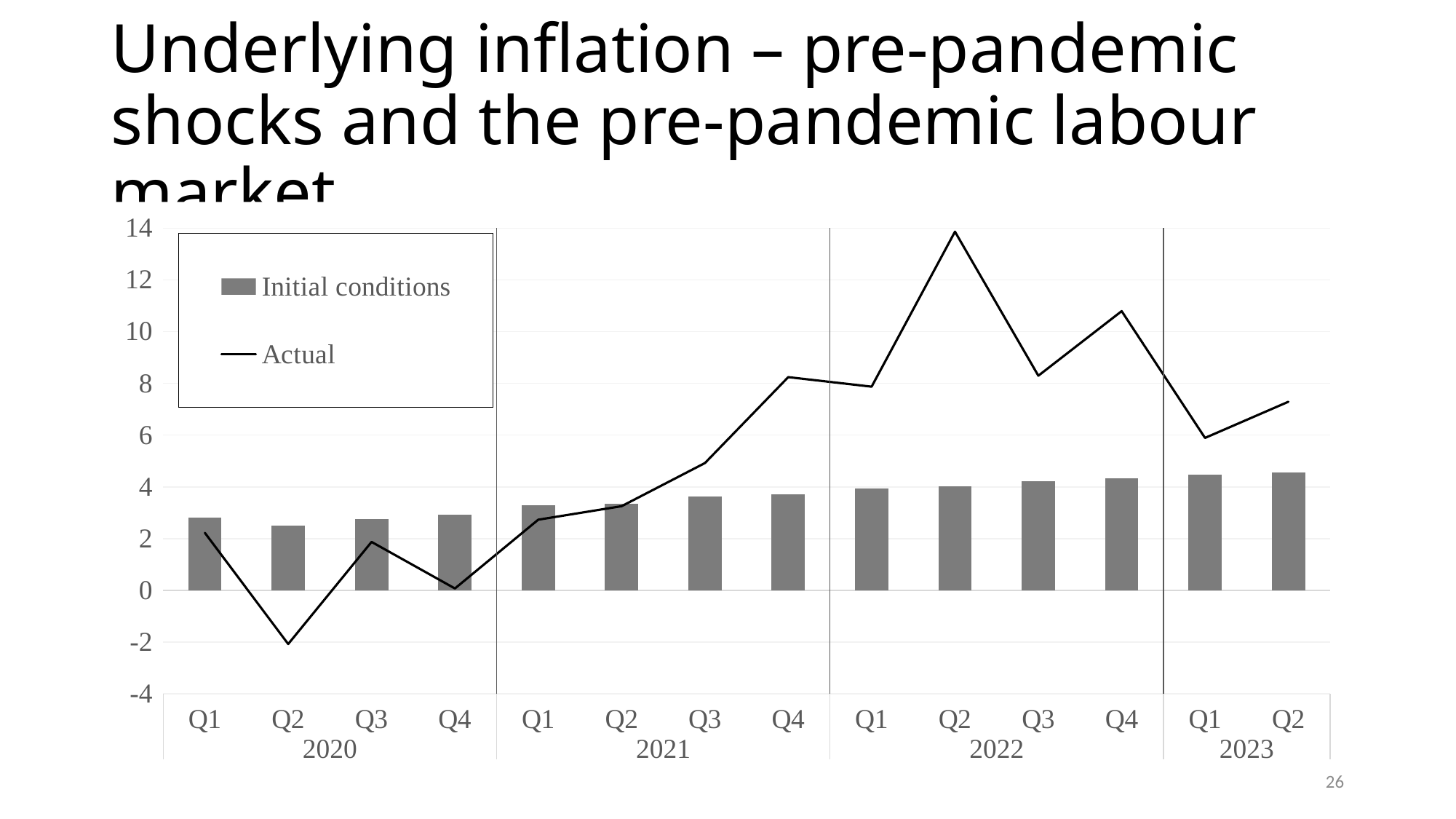
In which quarter does the Actual line reach its highest value? Q2 2022 Which series is drawn as a line? Actual Do the Initial conditions bars generally rise or fall from Q1 2021 to Q2 2023? rise How many series does the legend list? 2 What kind of chart is shown on the slide? A combined bar and line chart Which series is drawn as bars? Initial conditions Is the Actual value for Q2 2022 greater or less than 12? greater In Q2 2022, which is larger: the Actual value or the Initial conditions value? Actual How many quarters are plotted along the x axis? 14 In which quarter does the Actual line reach its lowest value? Q2 2020 Is the Initial conditions value for Q2 2023 greater or less than 4? greater Is the Actual value for Q2 2020 greater or less than 0? less